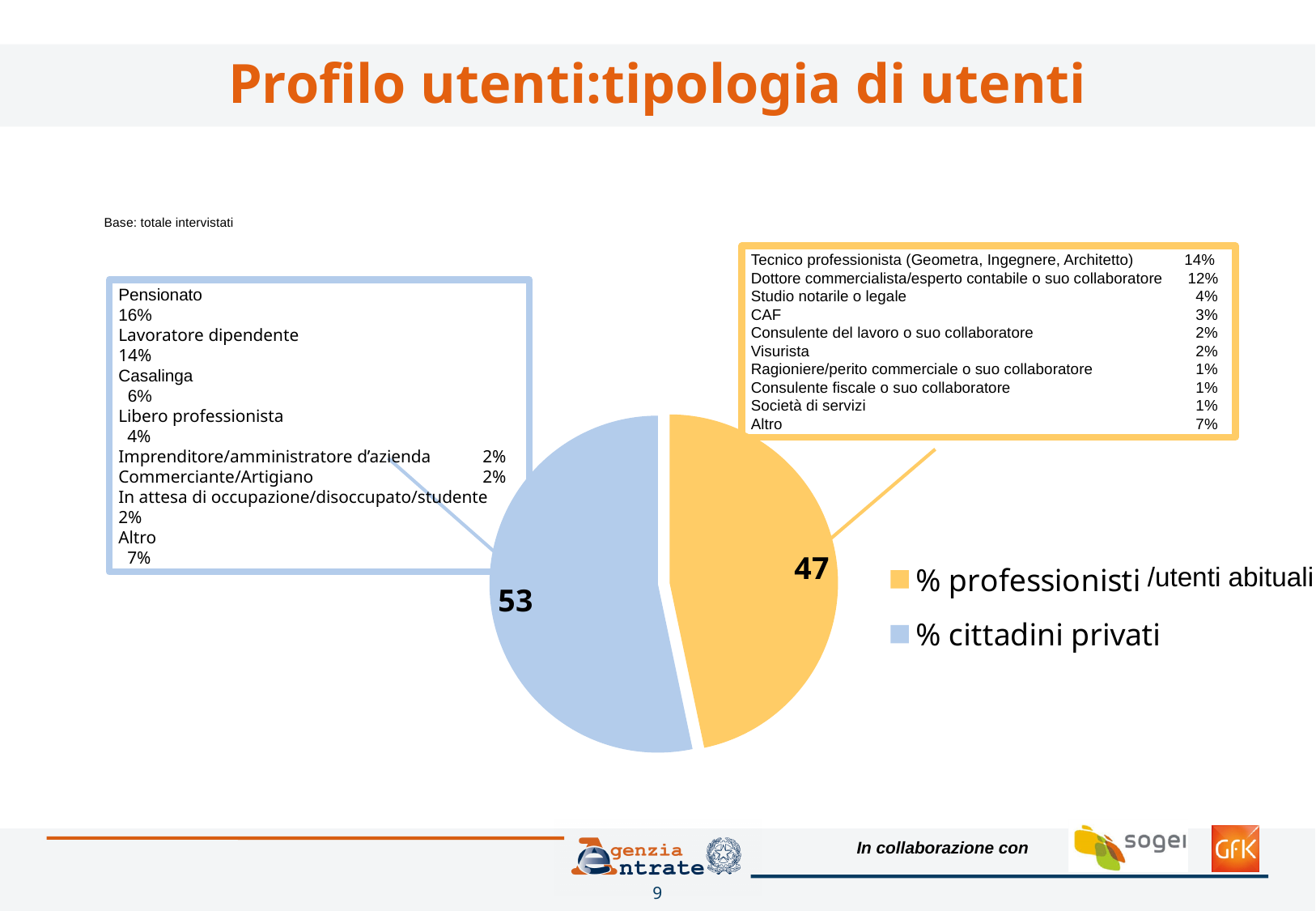
What colour is the % cittadini privati slice in the pie chart? Light blue What is the total of the two values shown on the pie chart? 100 What value is shown for the % professionisti /utenti abituali slice of the pie chart? 47 What kind of chart is shown on the slide? Pie chart Which slice of the pie chart is the largest? % cittadini privati What is the difference between the % cittadini privati value and the % professionisti /utenti abituali value in the pie chart? 6 How many slices does the pie chart have? 2 Which is larger in the pie chart: % cittadini privati or % professionisti /utenti abituali? % cittadini privati How many entries does the legend of the pie chart list? 2 What value is shown for the % cittadini privati slice of the pie chart? 53 Which slice of the pie chart is the smallest? % professionisti /utenti abituali What colour is the % professionisti /utenti abituali slice in the pie chart? Orange